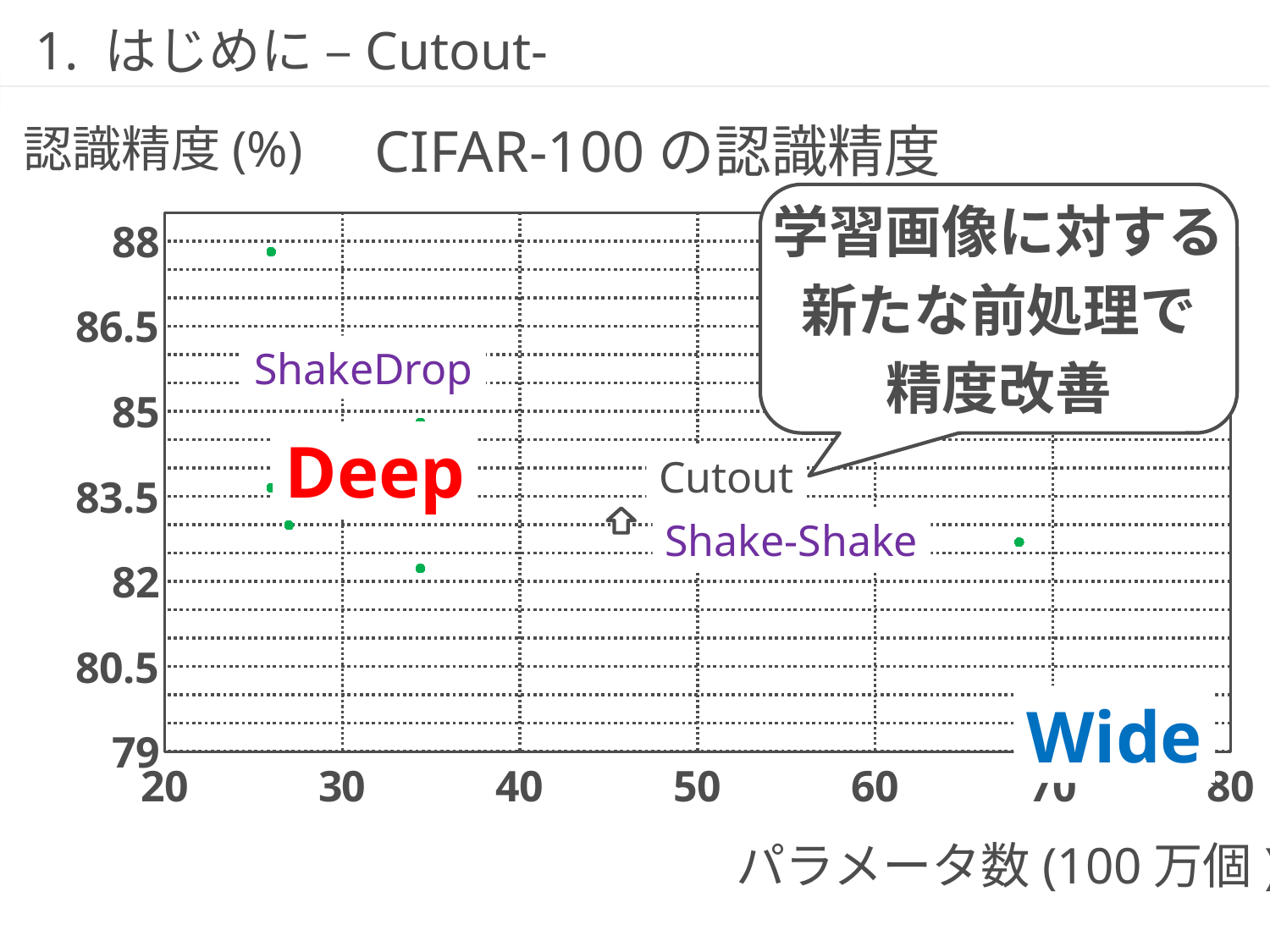
What kind of chart is shown on the slide? scatter plot Is the lowest plotted accuracy value greater or less than 80.5? greater Is the accuracy of the point plotted near 27 on the x axis at about 83 greater or less than 83.5? less Which has the higher accuracy: the point near x=26 at the top of the chart or the point near x=68? the point near x=26 Is the accuracy of the point plotted near 68 on the x axis (the Wide side) greater or less than 83.5? less What is the title of the chart? CIFAR-100 の認識精度 What is the label of the x axis? パラメータ数 (100 万個)